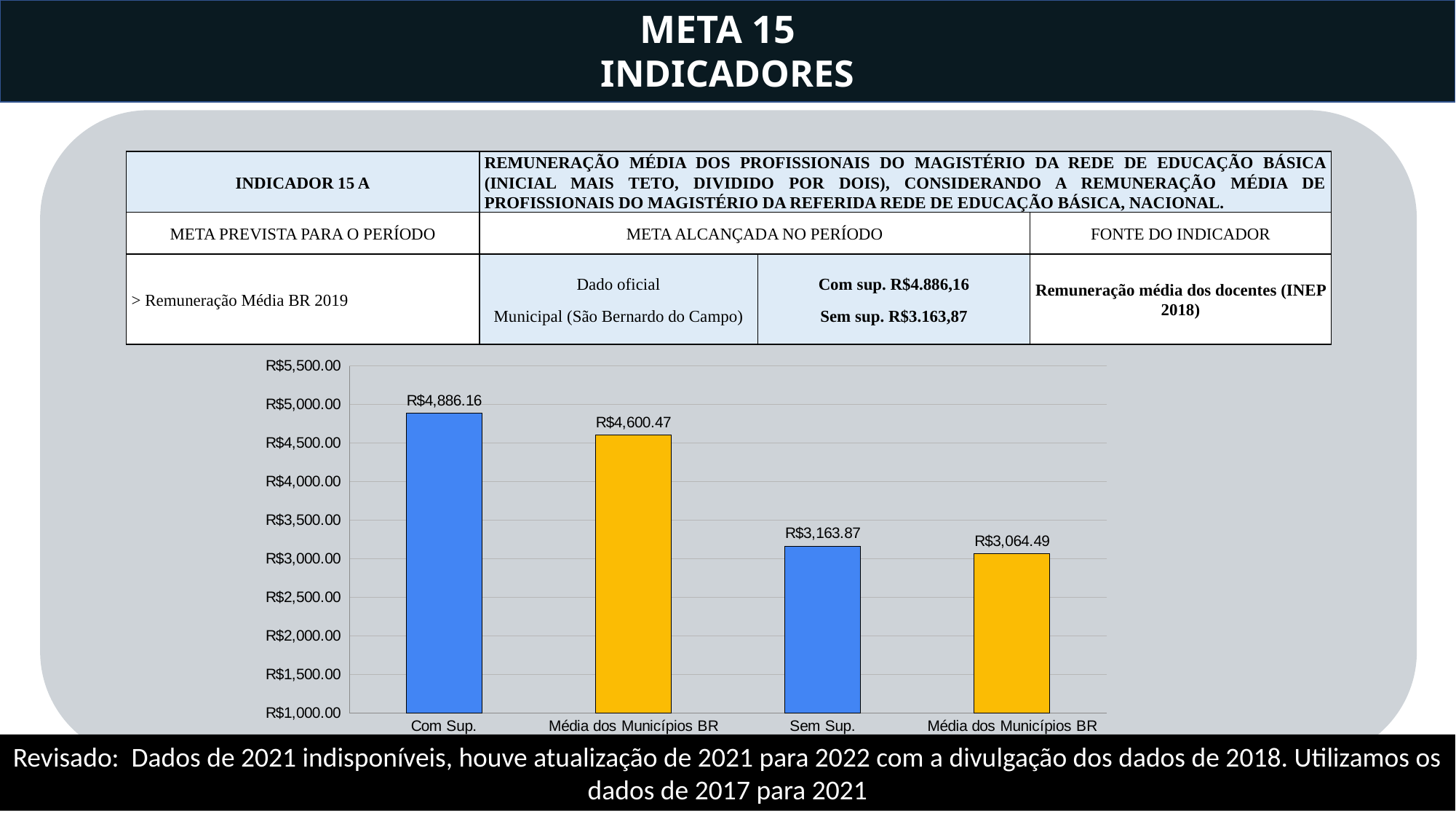
Which is larger, the Sem Sup. bar or the rightmost Média dos Municípios BR bar? Sem Sup. What type of chart is shown on the slide? bar chart How many bars are plotted in the chart? 4 What is the value of the rightmost bar, labelled Média dos Municípios BR (next to Sem Sup.)? R$3,064.49 What is the value of the Com Sup. bar? R$4,886.16 Which bar has the lowest value? Média dos Municípios BR (rightmost bar) Is the value for Sem Sup. greater or less than R$3,500.00? less What is the value of the Sem Sup. bar? R$3,163.87 What is the value of the second bar from the left, labelled Média dos Municípios BR (next to Com Sup.)? R$4,600.47 What is the difference between the Com Sup. bar and the Sem Sup. bar? R$1,722.29 What is the difference between the Com Sup. bar and the Média dos Municípios BR bar next to it? R$285.69 Which bar has the highest value? Com Sup.